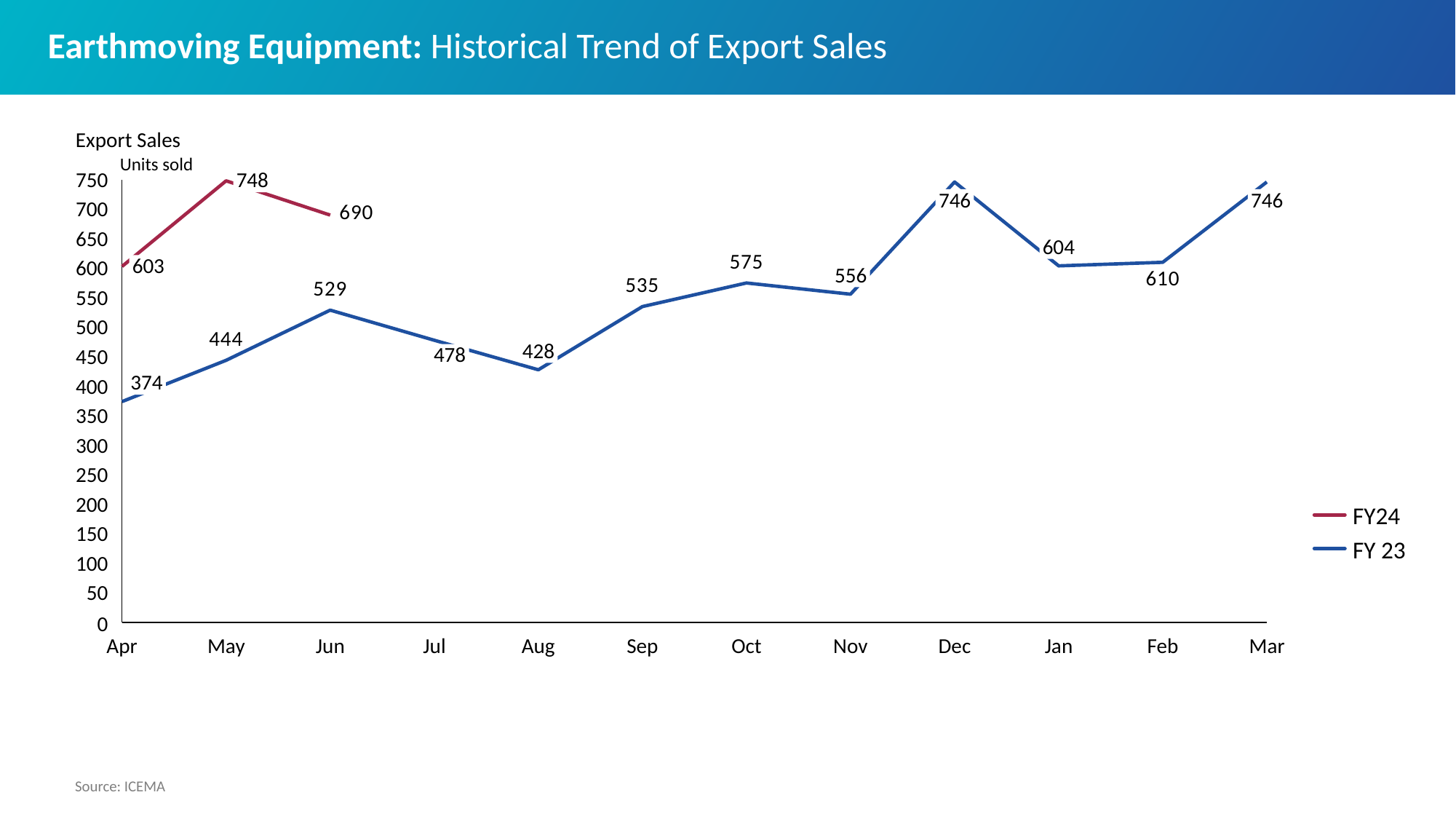
How many series does the legend list? 2 What is the difference between FY24 and FY 23 export sales in Jun? 161 Which is larger, FY 23 export sales in Dec or in Jan? Dec What is the FY24 export sales value for May? 748 Which month has the lowest FY 23 export sales? Apr What is the FY 23 export sales value for Oct? 575 Which month has the highest FY24 export sales? May What kind of chart is shown on the slide? Line chart How many months are shown on the x axis? 12 Is the FY 23 export sales value for Jul greater or less than 500? less What is the FY 23 export sales value for Aug? 428 Do FY 23 export sales rise or fall from Apr to Jun? Rise